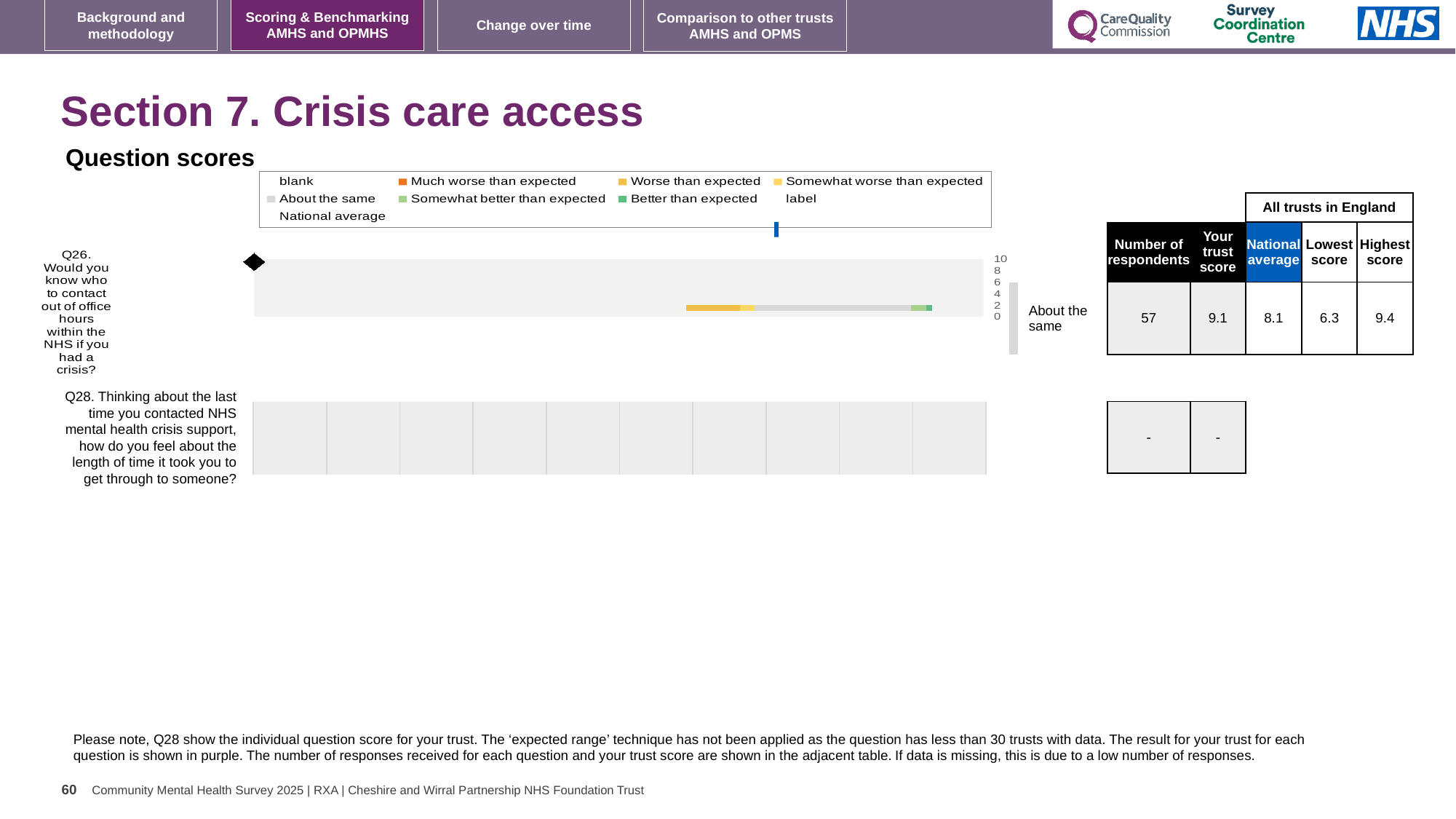
What is the national average score for Q26? 8.1 For Q26, which is larger: the trust score or the national average? Trust score What is the highest score among all trusts in England for Q26? 9.4 What is the trust score for Q26 (Would you know who to contact out of office hours within the NHS if you had a crisis?)? 9.1 What benchmark category is shown for the trust's Q26 result? About the same What is the lowest score among all trusts in England for Q26? 6.3 How many questions are plotted in the Question scores chart? 2 What is shown as the trust score for Q28 in the table? - How many respondents answered Q26? 57 What kind of chart is used to show the question scores? Bar chart By how much does the trust score for Q26 exceed the national average? 1.0 What is the difference between the highest and lowest trust scores in England for Q26? 3.1